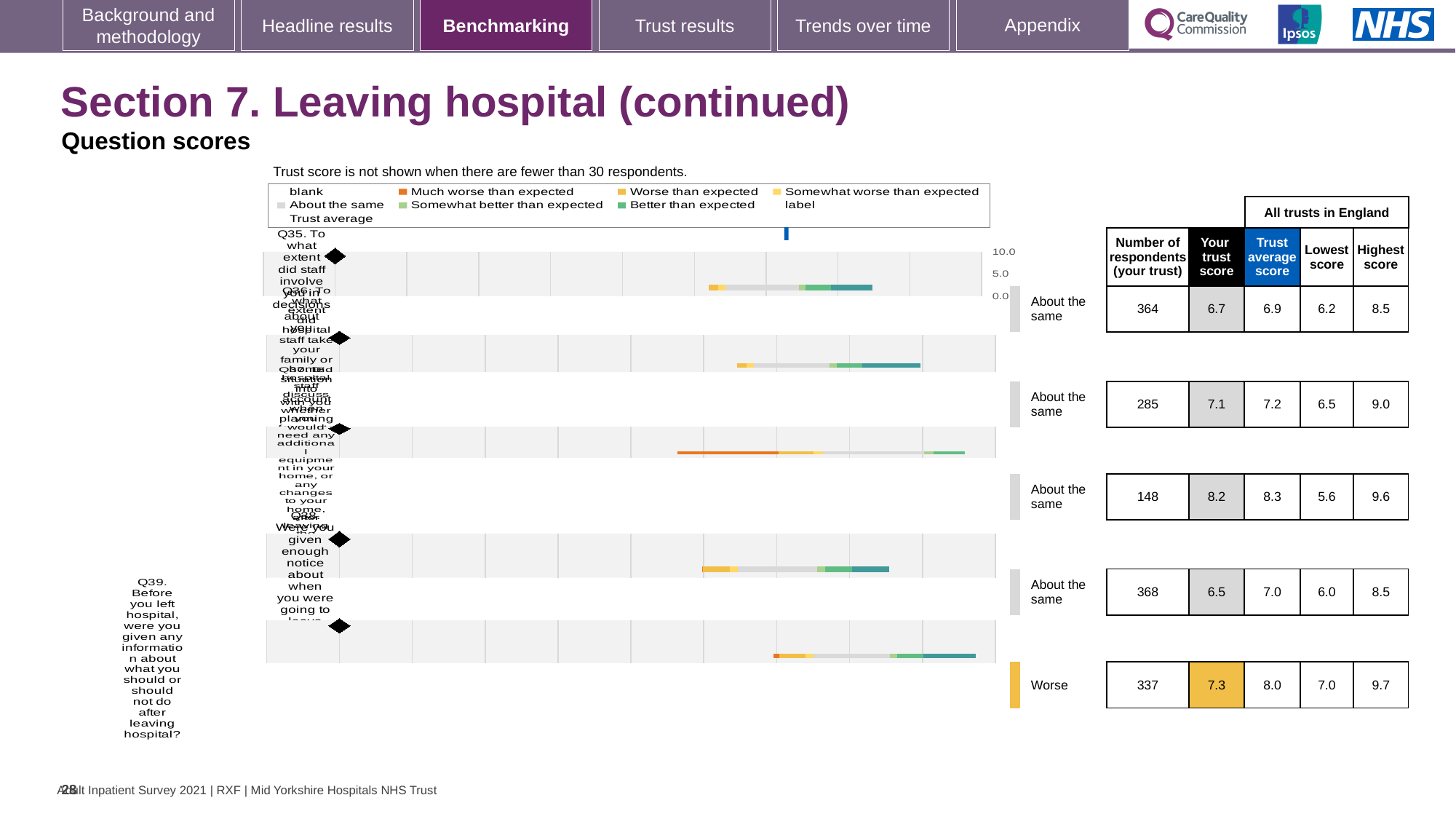
What is the 'Your trust score' value in the first row of the table? 6.7 Which row is rated 'Worse' rather than 'About the same'? The last (fifth) row In the first row of the table, which is larger: your trust score or the trust average score? Trust average score What is the 'Highest score' value in the third row of the table? 9.6 Which row of the table has the lowest 'Your trust score'? The fourth row (6.5) Which row of the table has the highest 'Your trust score'? The third row (8.2) How many respondents (your trust) are shown for the first row of the table? 364 In the third row of the table, what is the difference between the highest score and the lowest score? 4.0 What is the 'Lowest score' value in the second row of the table? 6.5 What kind of chart is used to show the question scores? Bar chart In the last row of the table, what is the difference between the trust average score (8.0) and your trust score (7.3)? 0.7 How many question rows are shown in the chart and table? 5